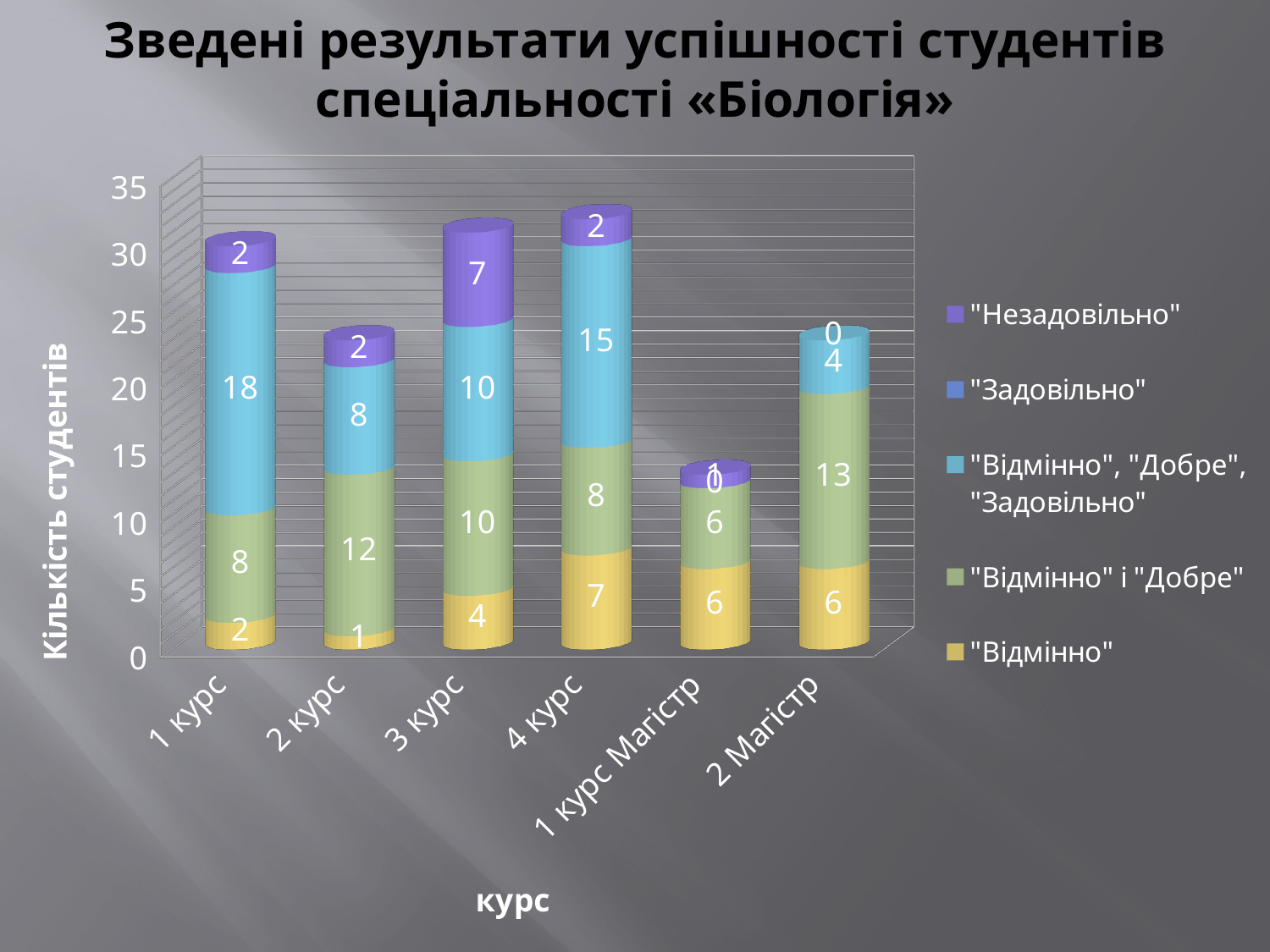
What is the difference between the "Відмінно" values for 4 курс and 1 курс? 5 What is the value of the "Відмінно" series for 4 курс? 7 What is the value of the "Відмінно", "Добре", "Задовільно" series for 1 курс? 18 What kind of chart is shown on the slide? Stacked bar chart Which category has the highest value for the "Відмінно" і "Добре" series? 2 Магістр What is the value of the "Відмінно" і "Добре" series for 2 Магістр? 13 Is the total height of the stacked bar for 4 курс greater or less than 30? greater Which has the larger "Незадовільно" value, 3 курс or 4 курс? 3 курс What is the value of the "Незадовільно" series for 3 курс? 7 Which category has the lowest value for the "Відмінно" series? 2 курс How many categories are shown on the x axis? 6 How many series does the legend list? 5